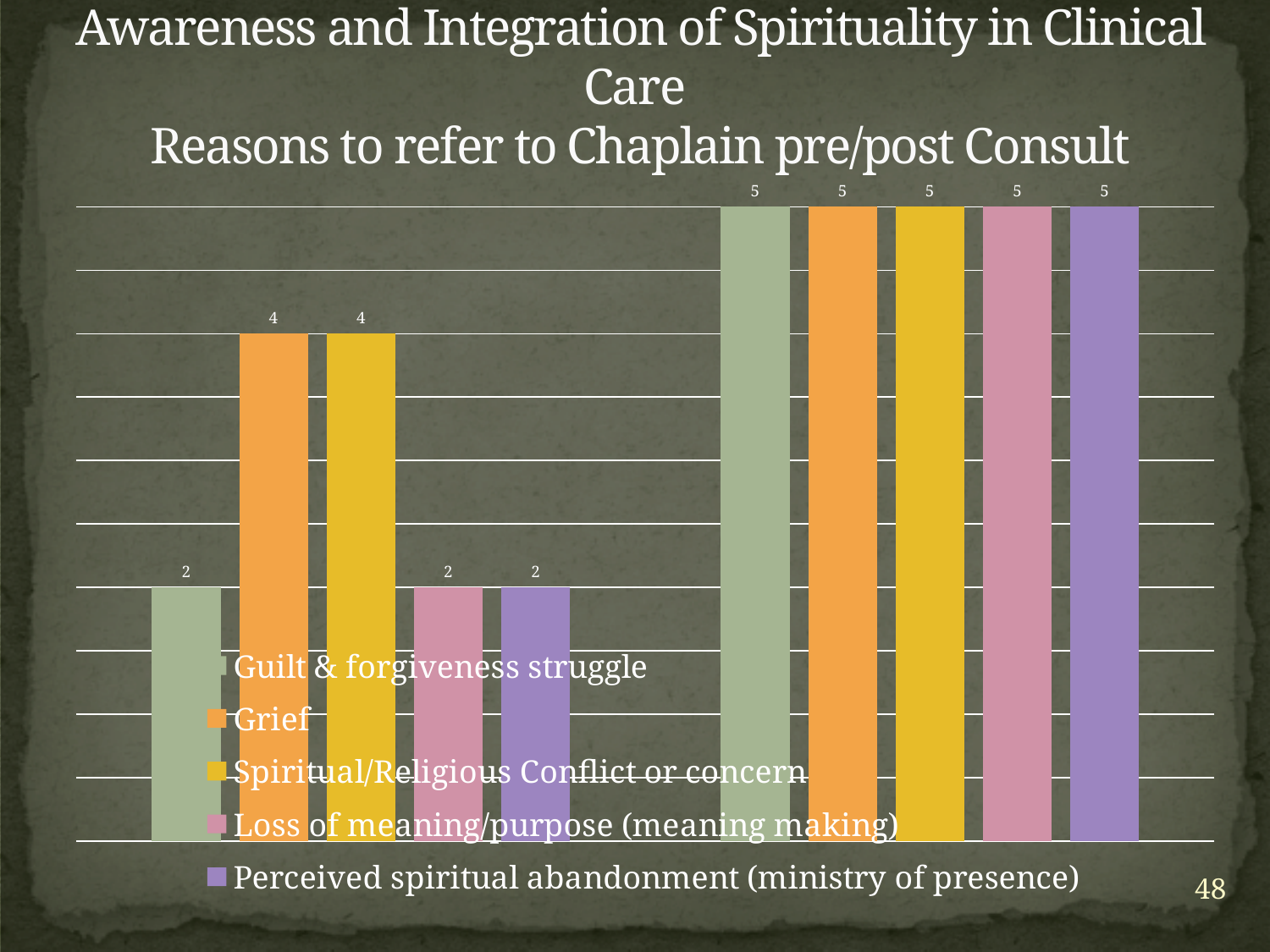
In the right group of bars, what is the value for Perceived spiritual abandonment (ministry of presence)? 5 What kind of chart is shown on the slide? bar chart How many groups of bars are plotted in the chart? 2 What colour represents Grief in the legend? orange What is the difference between the Grief value in the right group and the Grief value in the left group? 1 In the left group of bars, what is the value for Guilt & forgiveness struggle? 2 What is the difference between the Guilt & forgiveness struggle value in the right group and in the left group? 3 In the left group of bars, which is larger: Grief or Loss of meaning/purpose (meaning making)? Grief In the left group of bars, what is the value for Grief? 4 In the left group of bars, what is the value for Spiritual/Religious Conflict or concern? 4 How many series does the legend list? 5 What value do all five bars in the right group share? 5